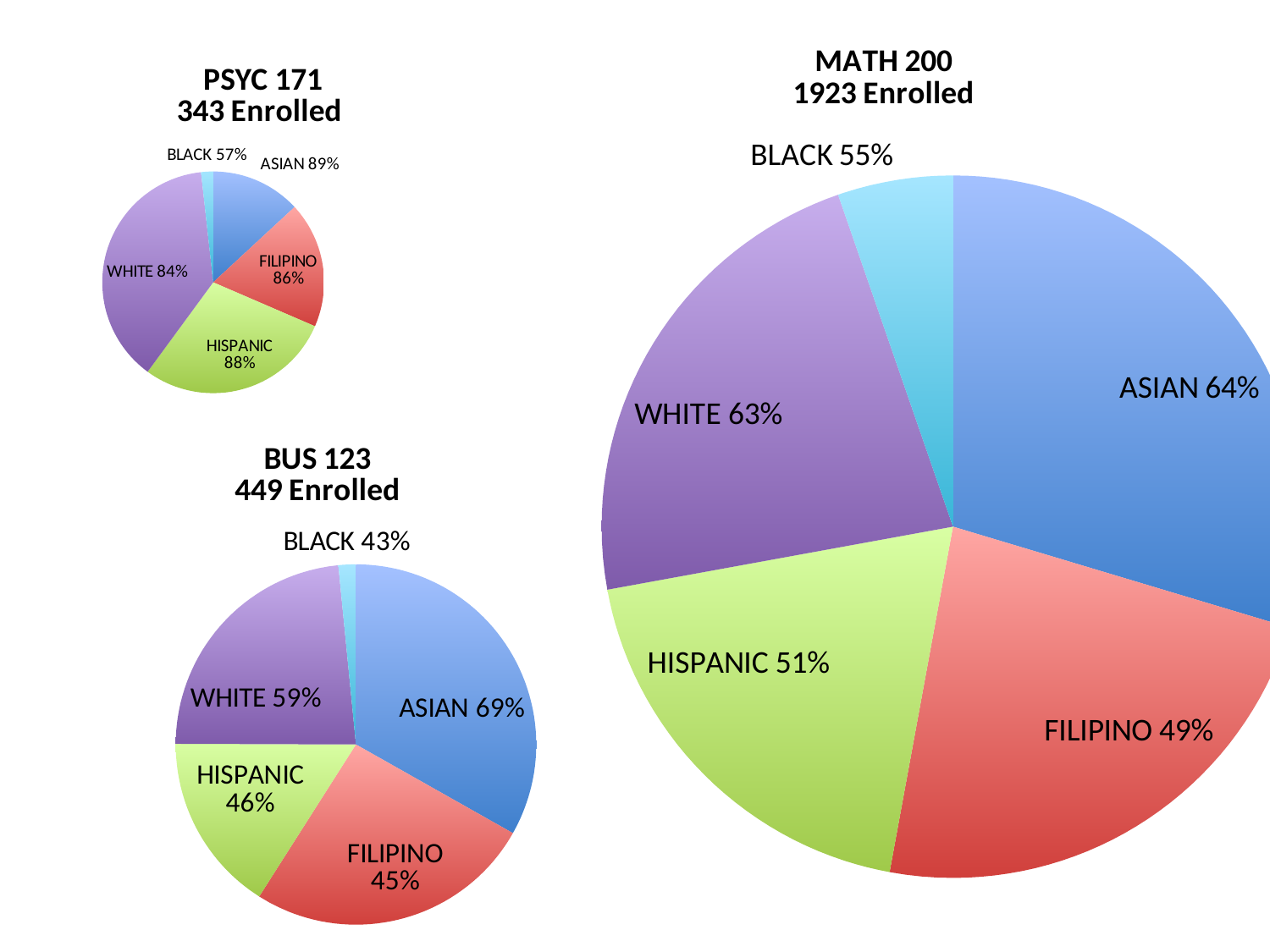
On the MATH 200 chart, which category has the highest labelled percentage? ASIAN How many slices does the BUS 123 pie chart have? 5 How many students are enrolled according to the MATH 200 chart title? 1923 On the MATH 200 chart, what percentage is shown for the FILIPINO label? 49% On the PSYC 171 chart, what percentage is shown for the HISPANIC label? 88% On the MATH 200 chart, which slice is the largest? ASIAN On the BUS 123 chart, what percentage is shown for the ASIAN label? 69% On the PSYC 171 chart, what is the difference between the labelled percentages for ASIAN and WHITE? 5% What type of chart is used for MATH 200? Pie chart On the PSYC 171 chart, what percentage is shown for the BLACK label? 57% On the BUS 123 chart, which category has the lowest labelled percentage? BLACK On the MATH 200 chart, which labelled percentage is larger, WHITE or HISPANIC? WHITE